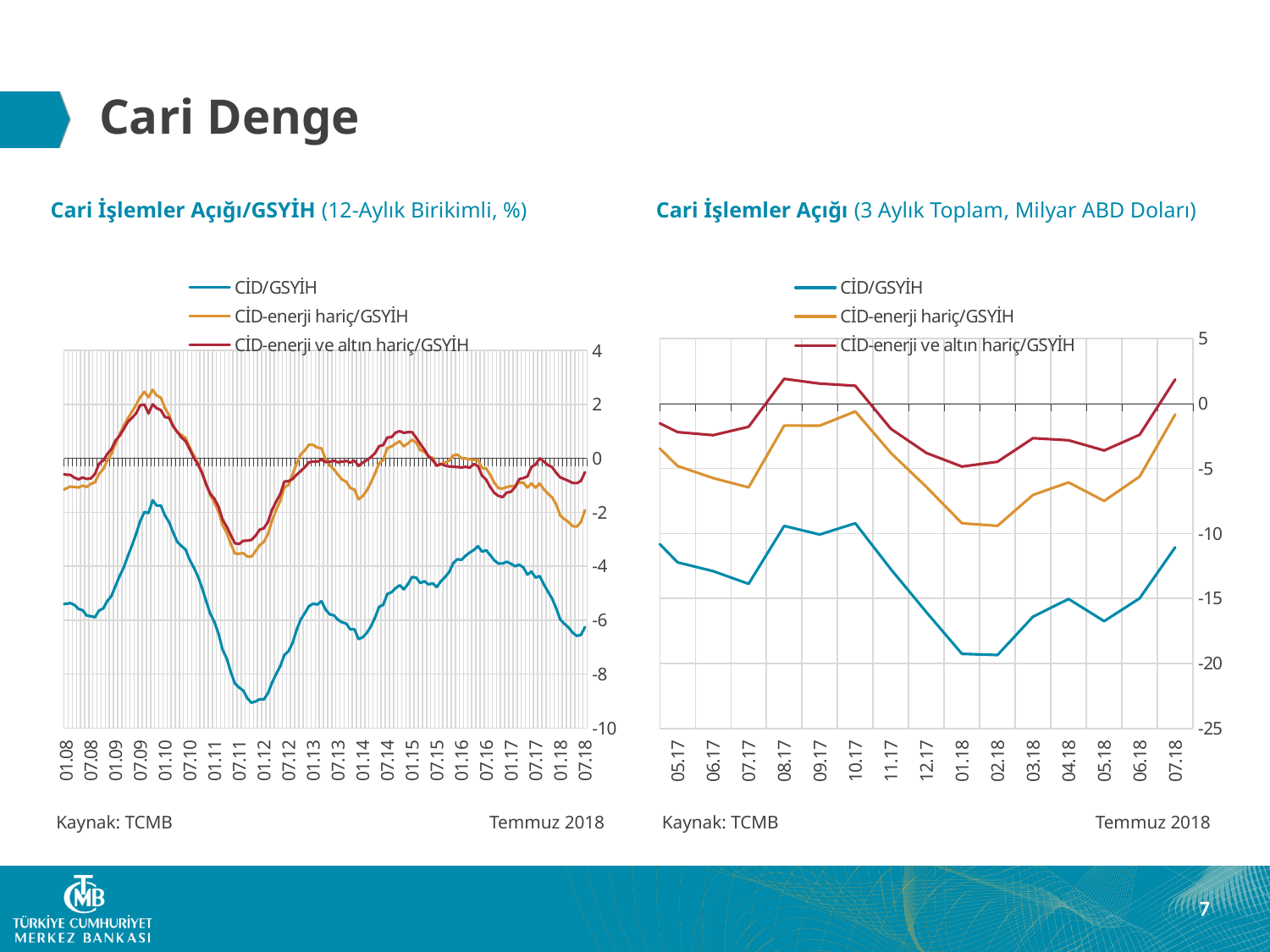
In the left chart, 'Cari İşlemler Açığı/GSYİH', does the CİD/GSYİH line rise or fall from 07.17 to 07.18? fall In the right chart, 'Cari İşlemler Açığı (3 Aylık Toplam)', is the value of CİD/GSYİH at 01.18 greater or less than -15? less In the right chart, 'Cari İşlemler Açığı (3 Aylık Toplam)', which series has the higher value at 07.18: CİD/GSYİH or CİD-enerji ve altın hariç/GSYİH? CİD-enerji ve altın hariç/GSYİH In the left chart, 'Cari İşlemler Açığı/GSYİH', is the value of CİD/GSYİH at 01.12 greater or less than -8? less What kind of chart is the left chart, 'Cari İşlemler Açığı/GSYİH'? line chart In the right chart, 'Cari İşlemler Açığı (3 Aylık Toplam)', does the CİD/GSYİH line rise or fall from 02.18 to 07.18? rise In the right chart, 'Cari İşlemler Açığı (3 Aylık Toplam)', which series has the lowest values across the whole period? CİD/GSYİH What is the source given below the left chart, 'Cari İşlemler Açığı/GSYİH'? TCMB In the right chart, 'Cari İşlemler Açığı (3 Aylık Toplam)', how many months are labelled on the x axis? 15 In the right chart, 'Cari İşlemler Açığı (3 Aylık Toplam)', is the value of CİD-enerji ve altın hariç/GSYİH at 07.18 greater or less than 0? greater How many series does the legend of the right chart, 'Cari İşlemler Açığı (3 Aylık Toplam, Milyar ABD Doları)', list? 3